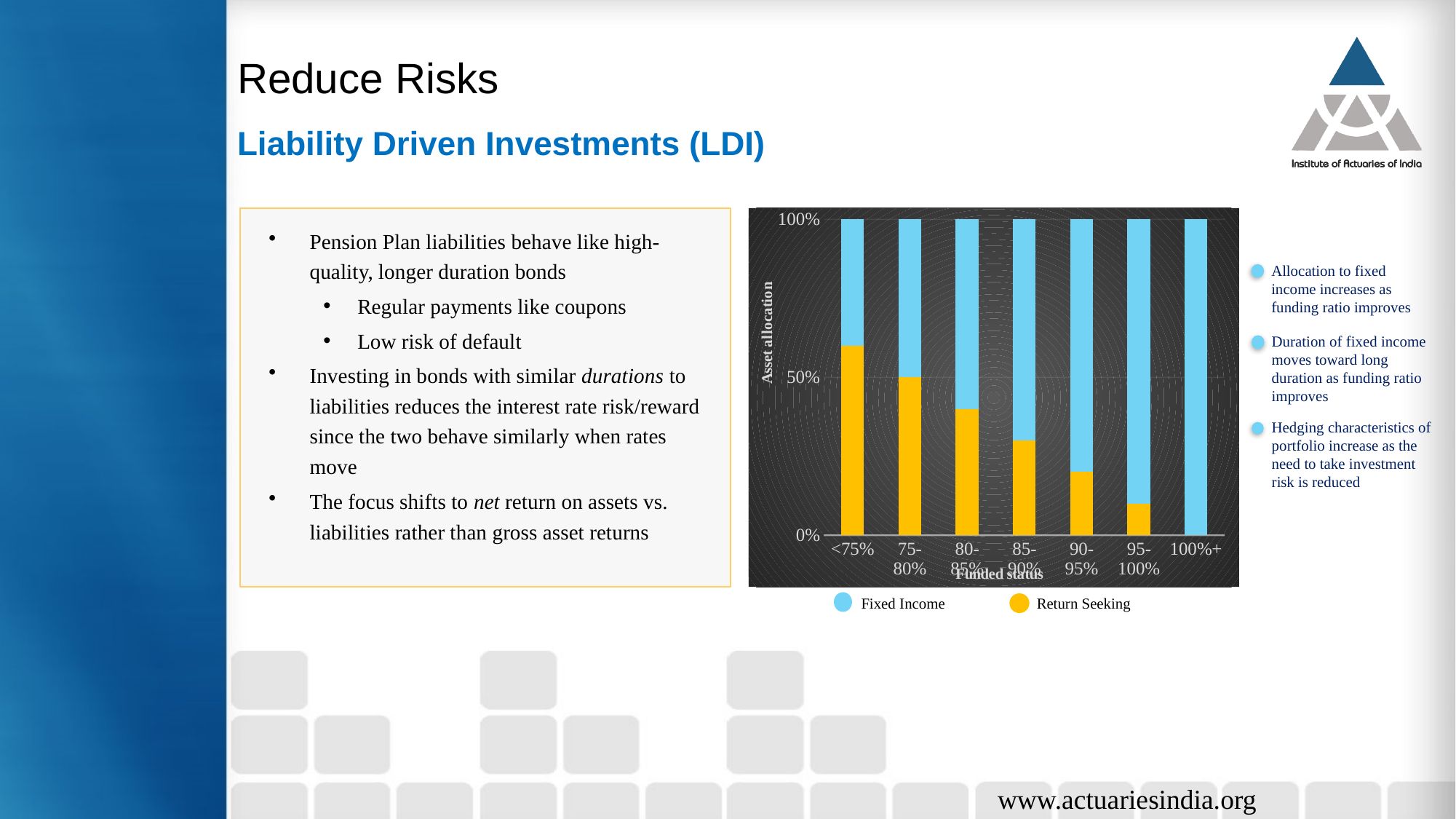
How many series does the chart's legend list? 2 What colour represents Return Seeking in the chart? yellow What kind of chart is shown on the slide? stacked bar chart Is the Return Seeking allocation for the <75% funded status greater or less than 50%? greater Is the Return Seeking allocation for the 80-85% funded status greater or less than 50%? less Which two series are listed in the chart's legend? Fixed Income and Return Seeking Does the Return Seeking allocation rise or fall as funded status increases along the x axis? fall Which funded status category has the lowest Return Seeking allocation? 100%+ How many funded status categories are shown on the x axis of the chart? 7 Does the Fixed Income allocation rise or fall as funded status increases along the x axis? rise Which funded status category has the highest Return Seeking allocation? <75% Which has the larger Fixed Income allocation, the 90-95% funded status or the <75% funded status? 90-95%